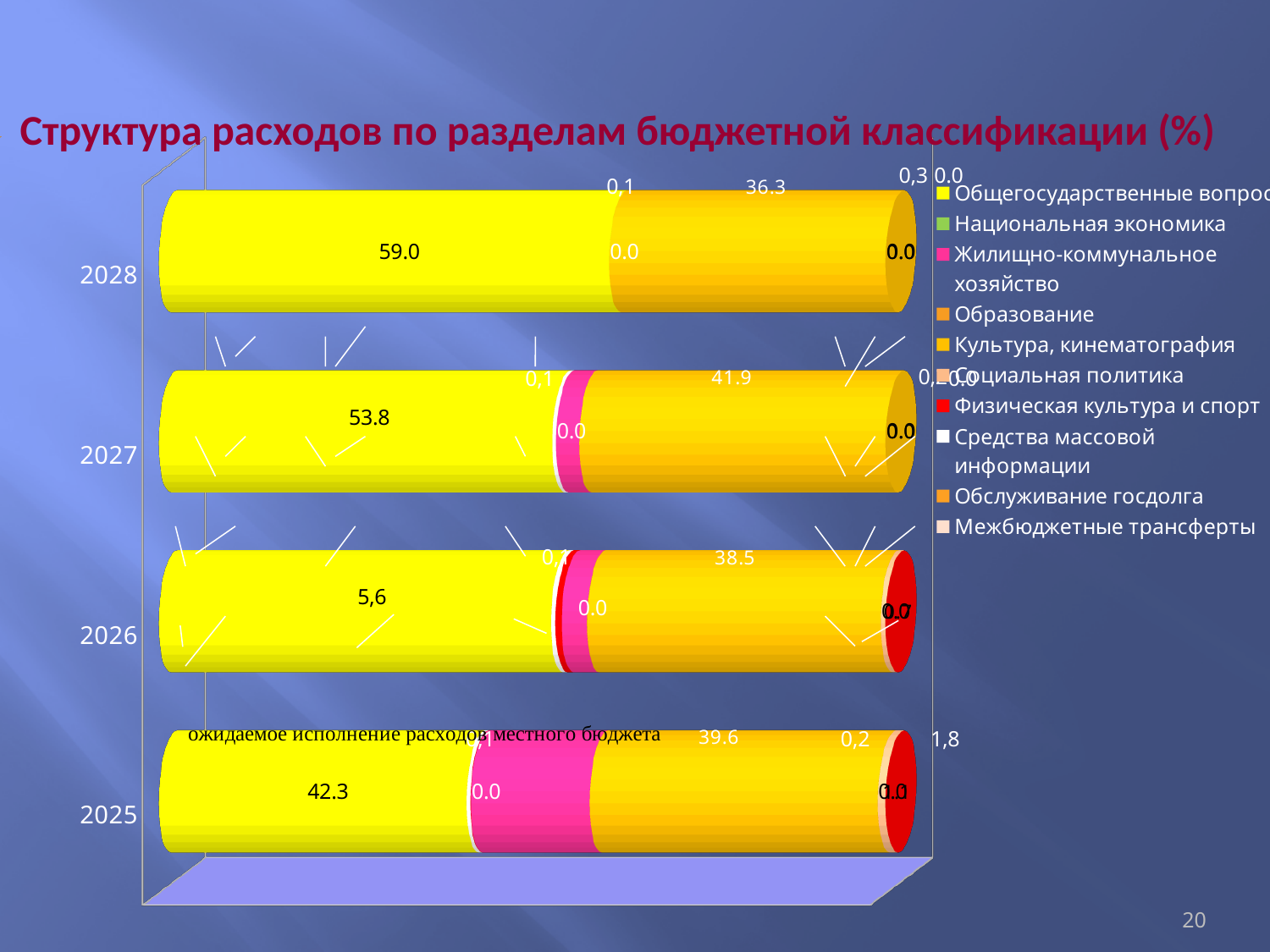
What is the first entry in the chart's legend? Общегосударственные вопросы What is the value for Общегосударственные вопросы in 2028? 59.0 In which year is the value for Общегосударственные вопросы the highest? 2028 What is the title of the chart? Структура расходов по разделам бюджетной классификации (%) Which year has the larger value for Общегосударственные вопросы, 2027 or 2025? 2027 How many years (categories) are plotted on the chart? 4 What is the value for Общегосударственные вопросы in 2025? 42.3 What data label is printed on the Общегосударственные вопросы segment for 2026? 5,6 What is the value for Общегосударственные вопросы in 2027? 53.8 What kind of chart is shown on the slide? bar chart How many series does the legend list? 10 What is the difference between the Общегосударственные вопросы values for 2028 and 2027? 5.2